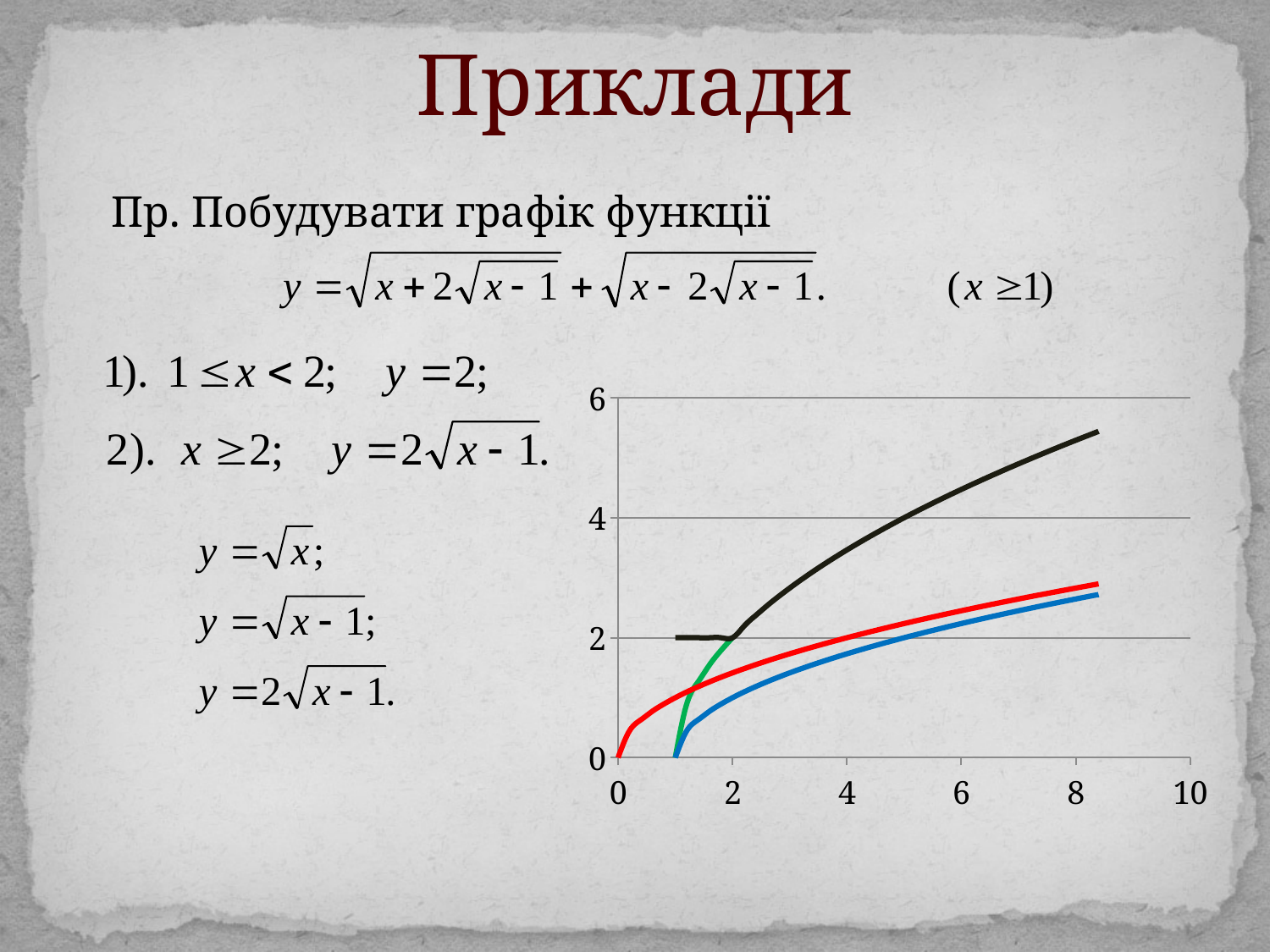
What is the value of the black curve at x = 1.5? 2 What is the highest value labelled on the x axis of the chart? 10 At x = 6, which curve is higher, the red one or the blue one? the red one How many curves are plotted on the chart? 4 What is the highest value labelled on the y axis of the chart? 6 Is the value of the black curve at x = 8 greater or less than 4? greater Which curve reaches the highest value on the chart? the black curve At x = 8, which curve is higher, the black one or the red one? the black one Is the value of the blue curve at x = 8 greater or less than 2? greater Is the value of the red curve at x = 8 greater or less than 4? less Do the curves on the chart rise or fall as x increases? rise What kind of chart is shown on the slide? line chart